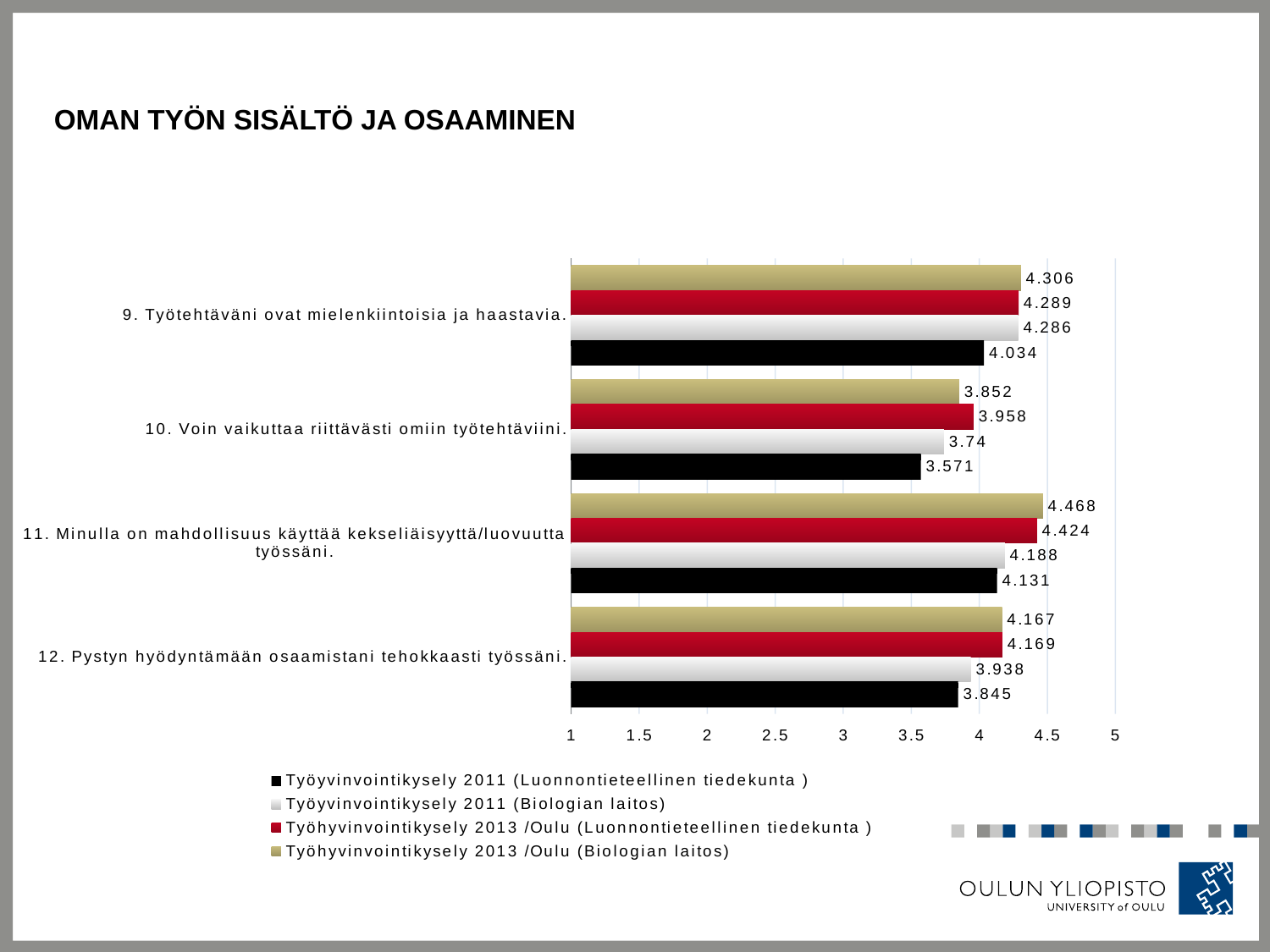
How many series does the legend list? 4 Which statement has the lowest value for Työyvinvointikysely 2011 (Luonnontieteellinen tiedekunta)? 10. Voin vaikuttaa riittävästi omiin työtehtäviini. Which statement has the highest value for Työhyvinvointikysely 2013 /Oulu (Biologian laitos)? 11. Minulla on mahdollisuus käyttää kekseliäisyyttä/luovuutta työssäni. What is the difference between the Työhyvinvointikysely 2013 /Oulu (Biologian laitos) value and the Työyvinvointikysely 2011 (Biologian laitos) value for statement 11? 0.28 What is the value for Työhyvinvointikysely 2013 /Oulu (Biologian laitos) for statement 11 (Minulla on mahdollisuus käyttää kekseliäisyyttä/luovuutta työssäni)? 4.468 What is the value for Työyvinvointikysely 2011 (Biologian laitos) for statement 12 (Pystyn hyödyntämään osaamistani tehokkaasti työssäni)? 3.938 What kind of chart is shown on the slide? bar chart What is the value for Työhyvinvointikysely 2013 /Oulu (Luonnontieteellinen tiedekunta) for statement 9 (Työtehtäväni ovat mielenkiintoisia ja haastavia)? 4.289 How many categories (statements) are plotted on the chart? 4 What is the value for Työyvinvointikysely 2011 (Luonnontieteellinen tiedekunta) for statement 10 (Voin vaikuttaa riittävästi omiin työtehtäviini)? 3.571 For statement 10, which is larger: the Työhyvinvointikysely 2013 /Oulu (Luonnontieteellinen tiedekunta) value or the Työhyvinvointikysely 2013 /Oulu (Biologian laitos) value? Työhyvinvointikysely 2013 /Oulu (Luonnontieteellinen tiedekunta) What is the title of the slide containing the chart? OMAN TYÖN SISÄLTÖ JA OSAAMINEN